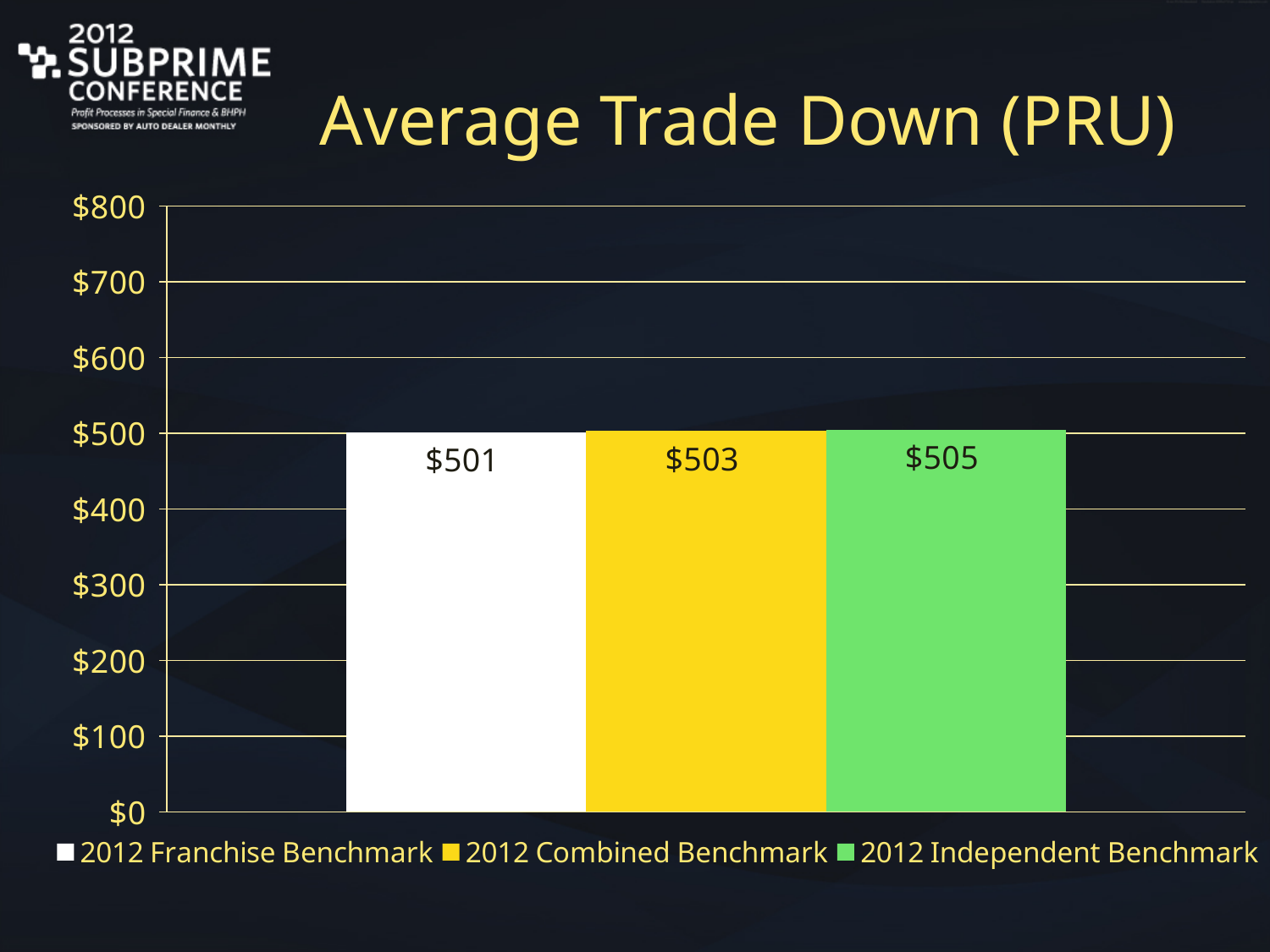
What is the value for 2012 Franchise Benchmark? $501 What colour is the bar for 2012 Independent Benchmark? green Is the value for 2012 Combined Benchmark greater or less than $600? less What is the title of the chart? Average Trade Down (PRU) Which series has the lowest value? 2012 Franchise Benchmark What kind of chart is shown on the slide? bar chart What is the value for 2012 Combined Benchmark? $503 What is the value for 2012 Independent Benchmark? $505 How many series does the legend list? 3 What is the difference between the 2012 Independent Benchmark and the 2012 Franchise Benchmark? $4 What is the difference between the 2012 Combined Benchmark and the 2012 Franchise Benchmark? $2 Which series has the highest value? 2012 Independent Benchmark